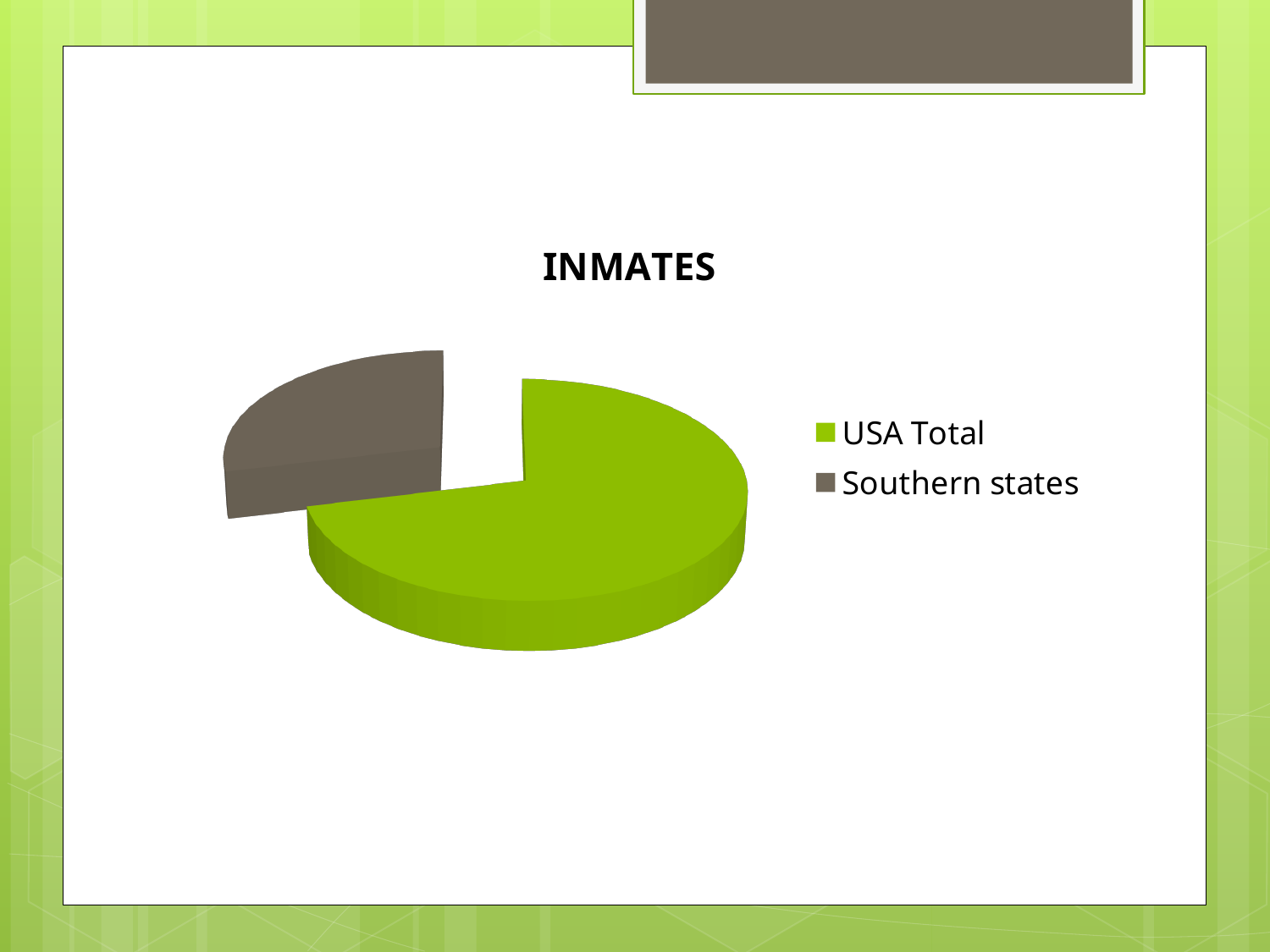
What kind of chart is shown on the slide? pie chart What is the title of the chart? INMATES How many entries does the legend list? 2 Which is larger, the USA Total slice or the Southern states slice? USA Total How many slices does the pie chart have? 2 Which slice is the smallest in the pie chart? Southern states Which slice is the largest in the pie chart? USA Total What colour is the USA Total slice? green